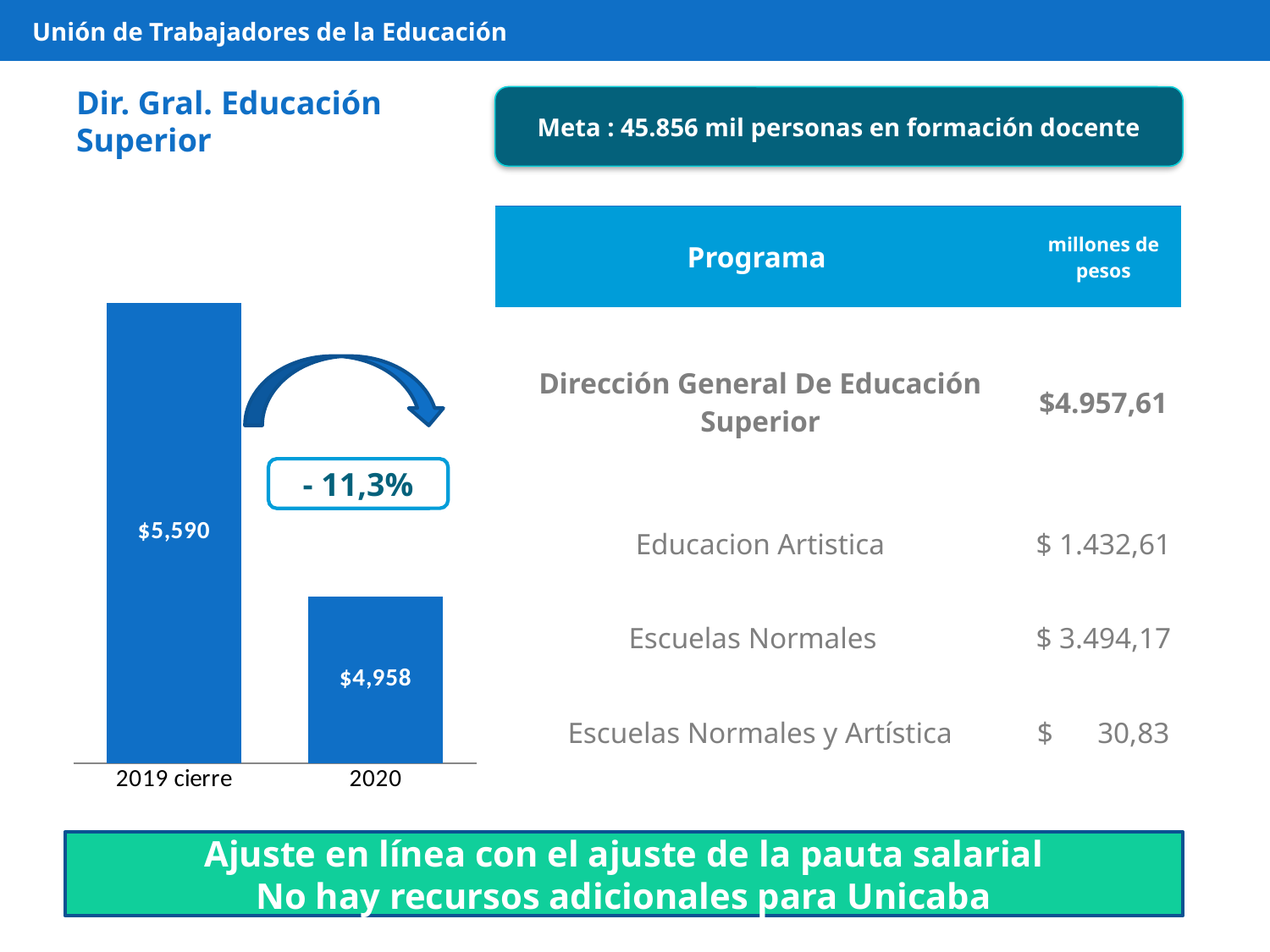
What percentage change is annotated between the two bars in the chart? - 11,3% Do the values in the bar chart rise or fall from 2019 cierre to 2020? Fall What kind of chart is shown on the slide? Bar chart Which is larger in the bar chart, the value for 2019 cierre or the value for 2020? 2019 cierre What is the value for 2019 cierre in the bar chart? $5,590 Which category has the highest value in the bar chart? 2019 cierre Which category has the lowest value in the bar chart? 2020 How many categories are shown in the bar chart? 2 What colour are the bars in the chart? Blue What is the difference between the 2019 cierre value and the 2020 value in the bar chart? $632 What is the value for 2020 in the bar chart? $4,958